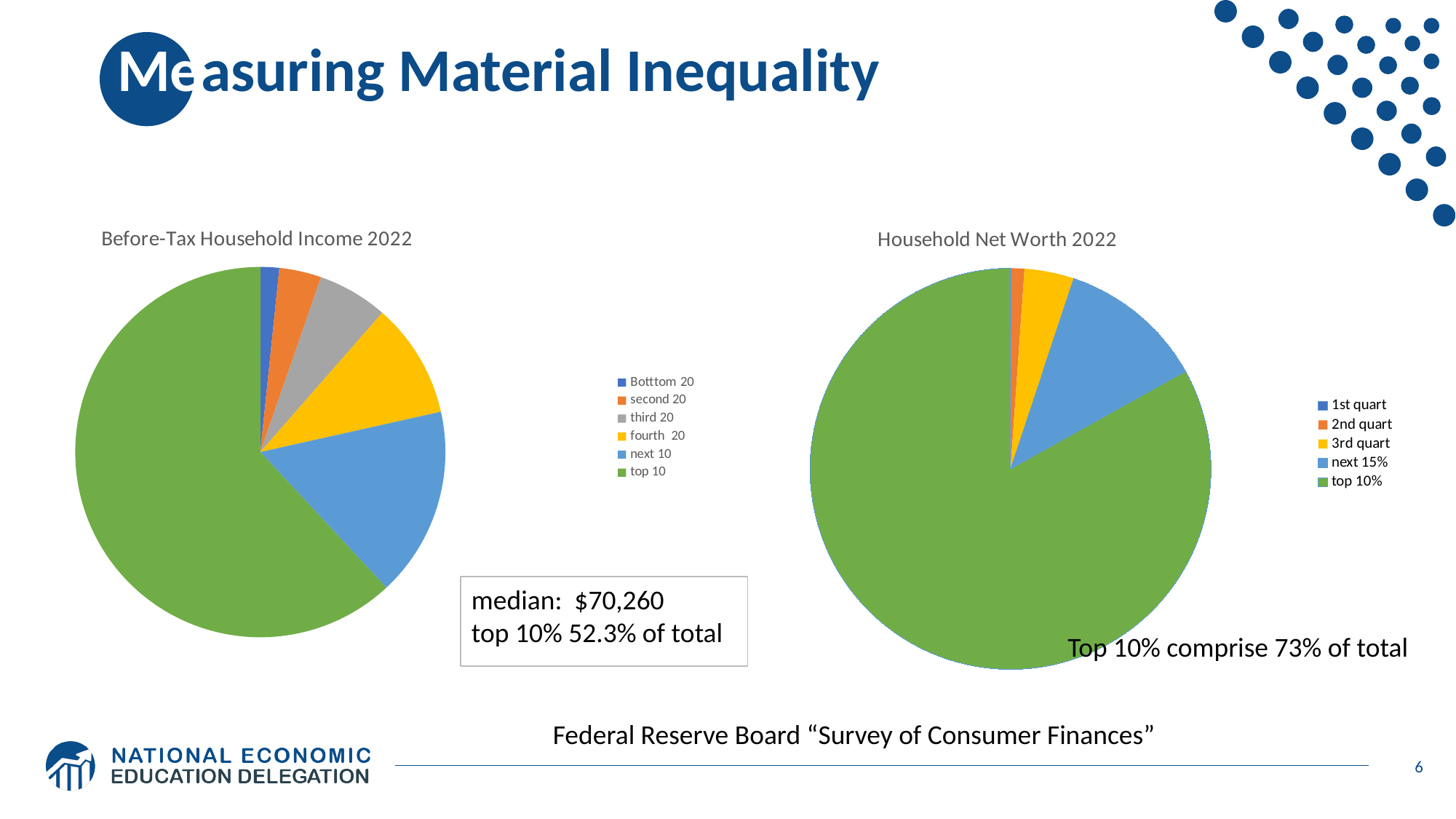
In the Household Net Worth 2022 chart, which category has the largest slice? top 10% In the Household Net Worth 2022 chart, what share of the total does the top 10% slice represent? 73% What kind of chart is the Before-Tax Household Income 2022 chart? pie chart What is the title of the pie chart on the right side of the slide? Household Net Worth 2022 In the Household Net Worth 2022 chart, which category has the smallest slice? 1st quart In the Before-Tax Household Income 2022 chart, which slice is larger, next 10 or fourth 20? next 10 How many categories does the legend of the Before-Tax Household Income 2022 chart list? 6 In the Household Net Worth 2022 chart, which slice is larger, next 15% or 3rd quart? next 15% In the Before-Tax Household Income 2022 chart, what share of the total does the top 10 slice represent? 52.3% In the Before-Tax Household Income 2022 chart, which category has the largest slice? top 10 In the Before-Tax Household Income 2022 chart, which category has the smallest slice? Botttom 20 How many categories does the legend of the Household Net Worth 2022 chart list? 5